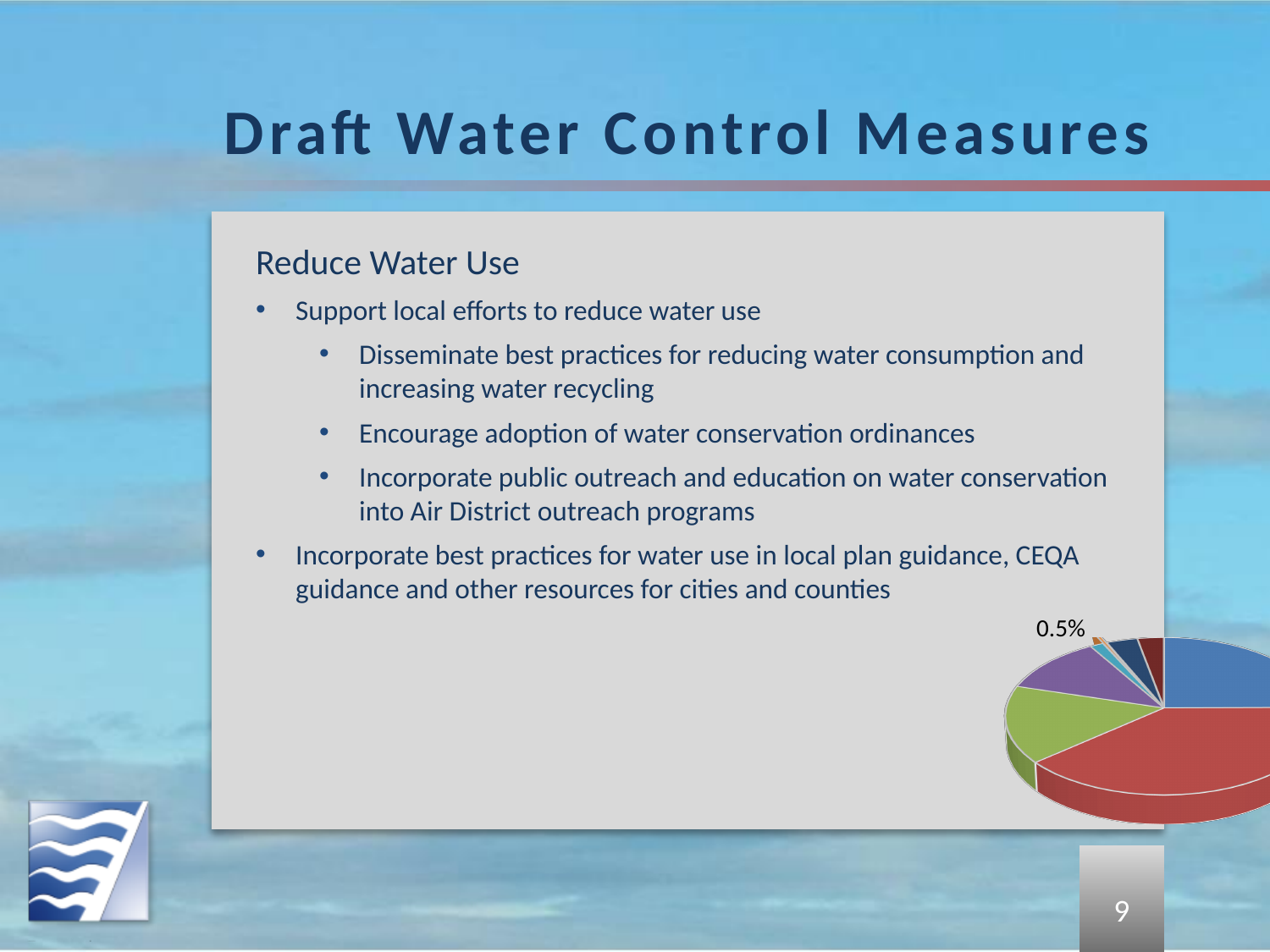
What share of the pie does the smallest labelled slice represent? 0.5% Does the pie chart have a title? No What is the only data label printed on the pie chart? 0.5% Is the slice labelled 0.5% greater or less than 1% of the pie? less Does the pie chart have a legend? No Which colour slice of the pie chart is the largest? red Which is larger in the pie chart, the red slice or the green slice? red Which is larger in the pie chart, the blue slice or the purple slice? blue What kind of chart is shown on the slide? pie chart